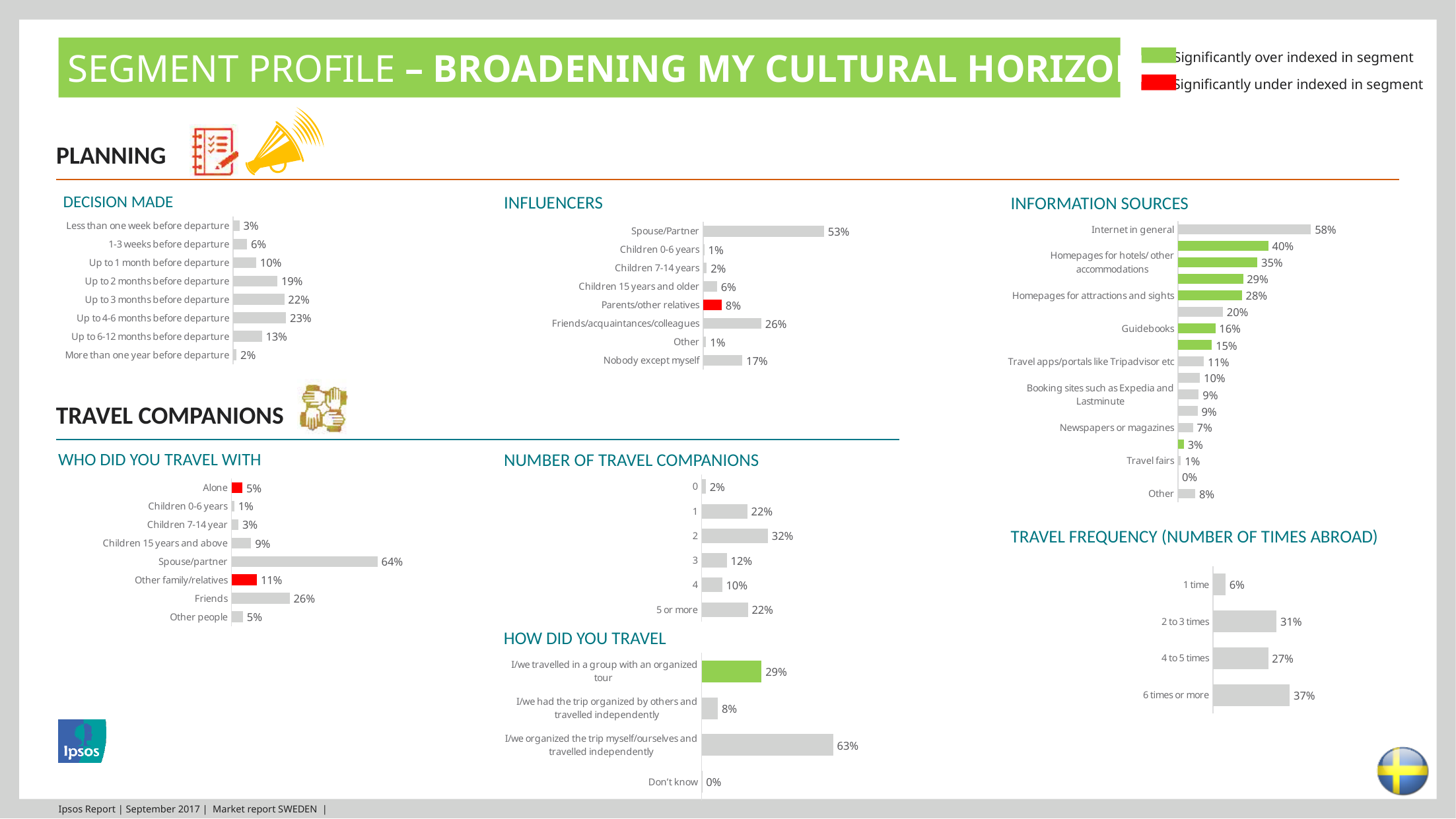
What type of chart is the TRAVEL FREQUENCY (NUMBER OF TIMES ABROAD) chart? Bar chart In the INFLUENCERS chart, what is the value for Spouse/Partner? 53% In the WHO DID YOU TRAVEL WITH chart, how many categories are shown? 8 In the INFORMATION SOURCES chart, what is the value for Internet in general? 58% In the WHO DID YOU TRAVEL WITH chart, which category has the highest value? Spouse/partner In the HOW DID YOU TRAVEL chart, what is the value for 'I/we organized the trip myself/ourselves and travelled independently'? 63% In the INFORMATION SOURCES chart, which is larger: Guidebooks or Travel apps/portals like Tripadvisor etc? Guidebooks In the TRAVEL FREQUENCY (NUMBER OF TIMES ABROAD) chart, which category has the highest value? 6 times or more In the NUMBER OF TRAVEL COMPANIONS chart, what percentage travelled with 2 companions? 32% In the DECISION MADE chart, which category has the lowest value? More than one year before departure In the DECISION MADE chart, what percentage decided up to 4-6 months before departure? 23% In the INFLUENCERS chart, what is the difference between Friends/acquaintances/colleagues and Nobody except myself? 9%